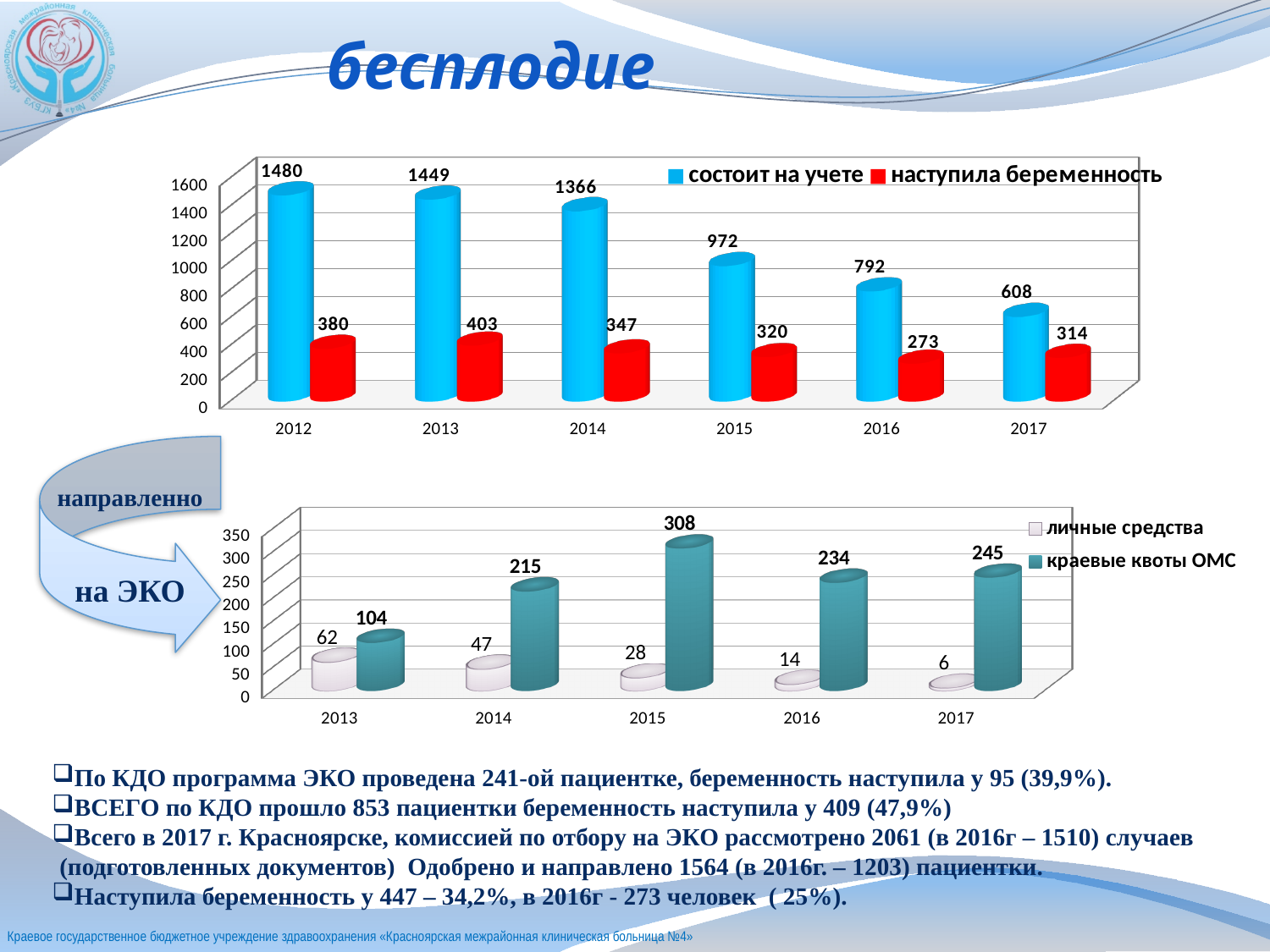
In the top chart, does the 'состоит на учете' series rise or fall from 2012 to 2017? fall In the bottom chart, which year has the highest value for 'краевые квоты ОМС'? 2015 In the top chart, which year has the lowest value for 'состоит на учете'? 2017 In the top chart, what is the difference between 'состоит на учете' and 'наступила беременность' in 2017? 294 In the top chart, what is the value for 'состоит на учете' in 2012? 1480 In the top chart, what is the value for 'наступила беременность' in 2016? 273 In the top chart, which year has the highest value for 'наступила беременность'? 2013 In the bottom chart, what is the value for 'личные средства' in 2017? 6 In the bottom chart, which is larger in 2014: 'личные средства' or 'краевые квоты ОМС'? краевые квоты ОМС How many series does the legend of the bottom chart list? 2 How many years are shown on the x axis of the top chart? 6 In the bottom chart, what is the value for 'краевые квоты ОМС' in 2015? 308